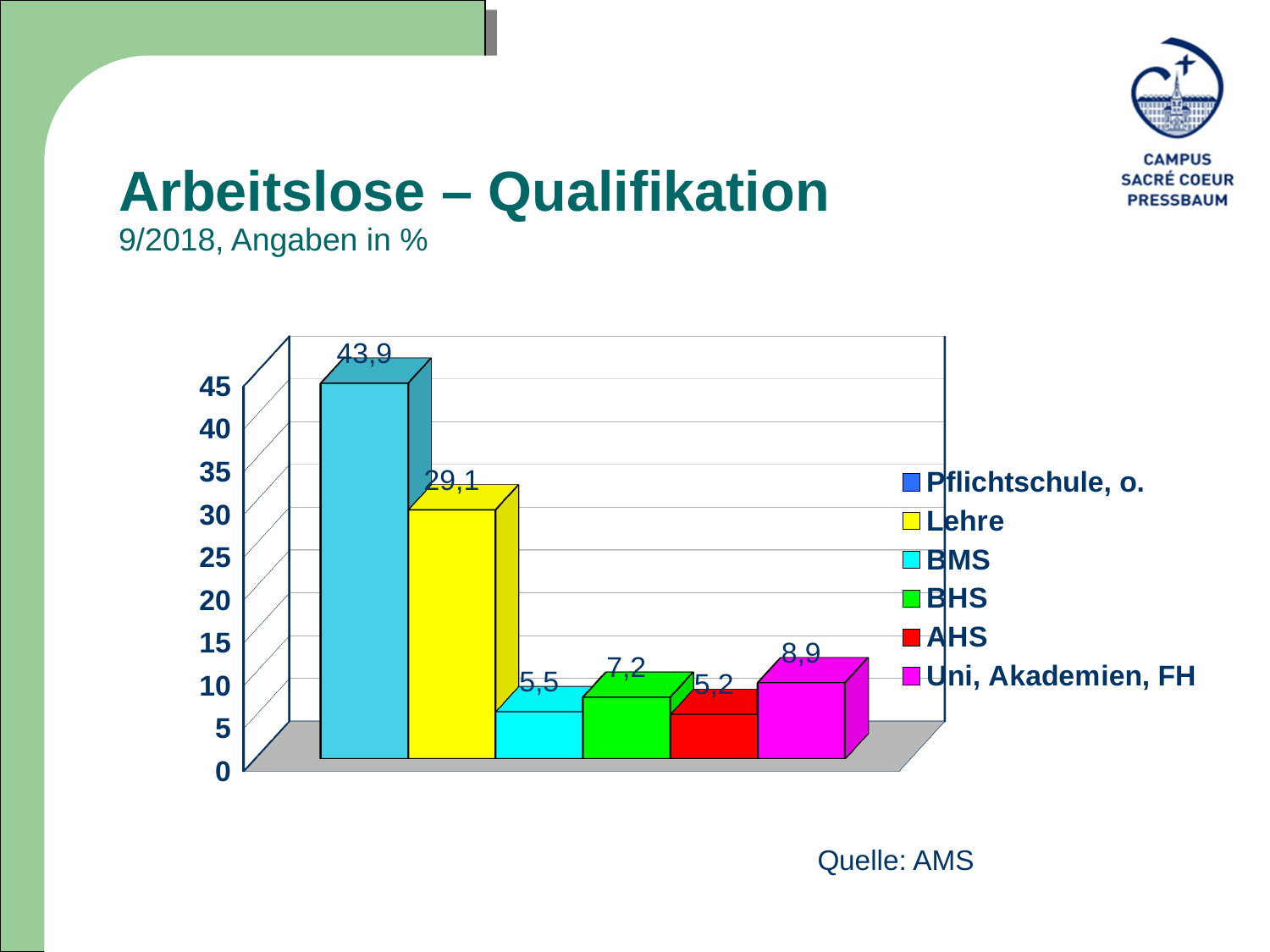
What kind of chart is shown on the slide? Bar chart What is the title of the chart on the slide? Arbeitslose – Qualifikation What is the difference between the values for Pflichtschule, o. and Lehre? 14,8 What is the value for Uni, Akademien, FH? 8,9 What is the value for BHS? 7,2 What is the value for Lehre? 29,1 Which category has the highest value? Pflichtschule, o. How many entries does the legend list? 6 What is the difference between the values for Uni, Akademien, FH and BMS? 3,4 Which is larger, the value for BHS or the value for AHS? BHS How many bars are shown in the chart? 6 Which category has the lowest value? AHS